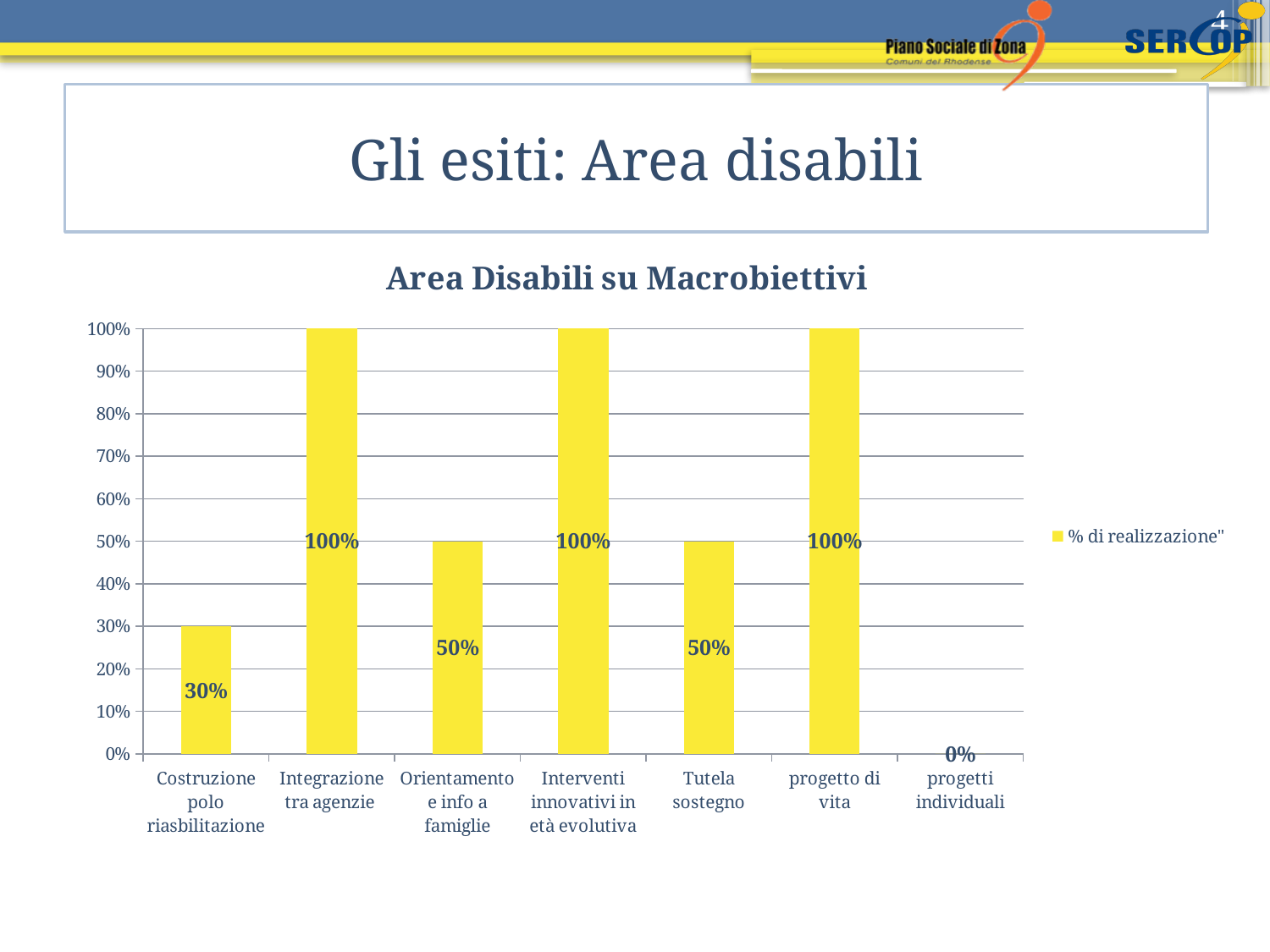
How many series does the legend list? 1 Which is larger, the value for Tutela sostegno or the value for Costruzione polo riasbilitazione? Tutela sostegno What is the difference between the values for Orientamento e info a famiglie and Costruzione polo riasbilitazione? 20% What kind of chart is shown? bar chart What is the title of the chart? Area Disabili su Macrobiettivi How many categories are shown on the x axis? 7 Which category has the lowest value? progetti individuali What is the value for Integrazione tra agenzie? 100% How many categories have a value of 100%? 3 What is the value for progetti individuali? 0% What is the value for Tutela sostegno? 50% What is the value for Costruzione polo riasbilitazione? 30%